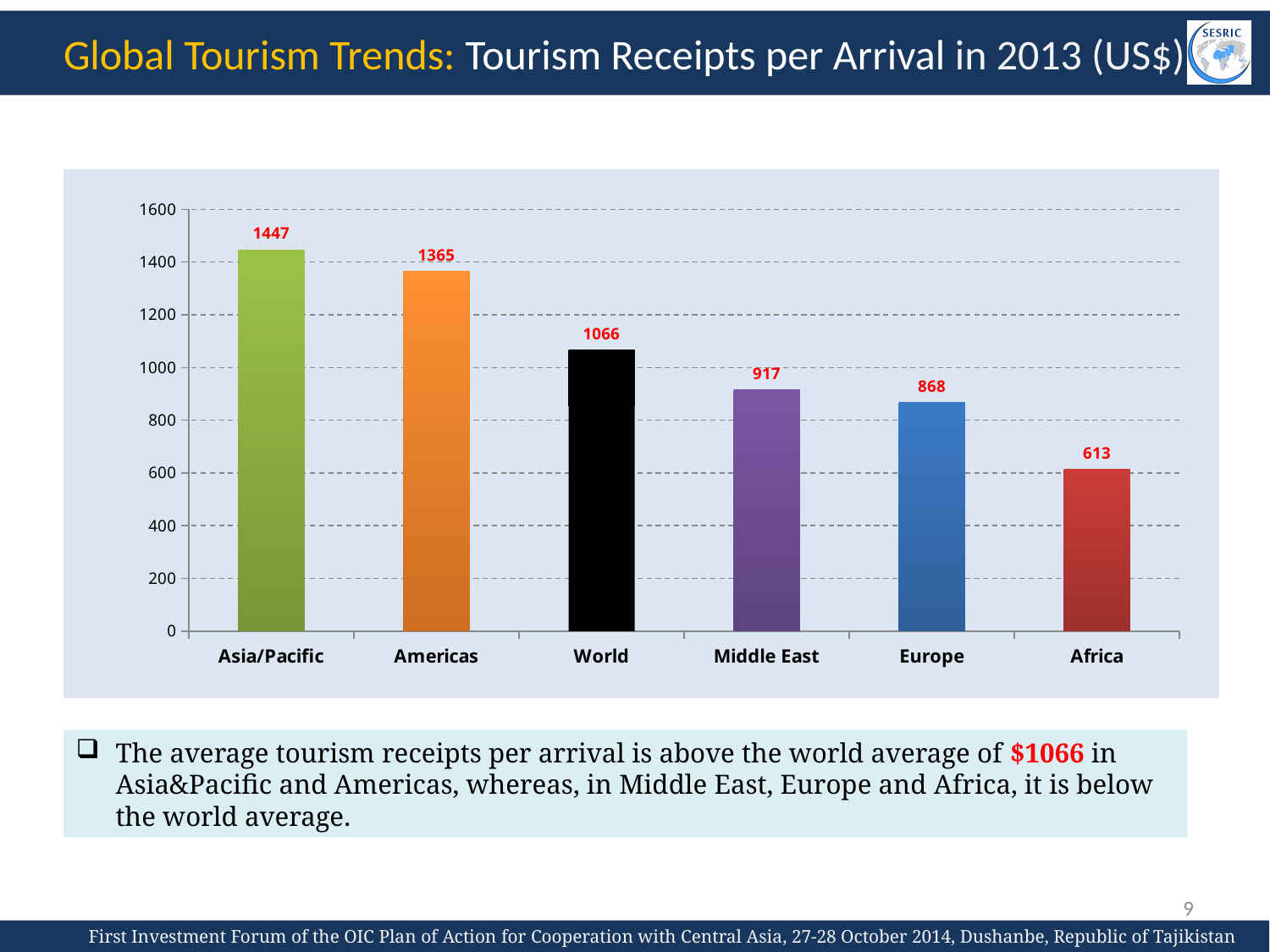
Is the value for Americas greater or less than 1200? greater Do the values rise or fall moving from left to right along the x axis? Fall Which region has the highest tourism receipts per arrival? Asia/Pacific What is the tourism receipts per arrival value for Asia/Pacific? 1447 What is the difference between the World value and the Europe value? 198 How many categories are shown on the x axis? 6 What kind of chart is shown on the slide? Bar chart What is the value shown for Africa? 613 What is the value shown for the Middle East? 917 Which is larger, the value for Middle East or the value for Europe? Middle East What is the difference between the values for Asia/Pacific and Americas? 82 Which category has the lowest value in the chart? Africa